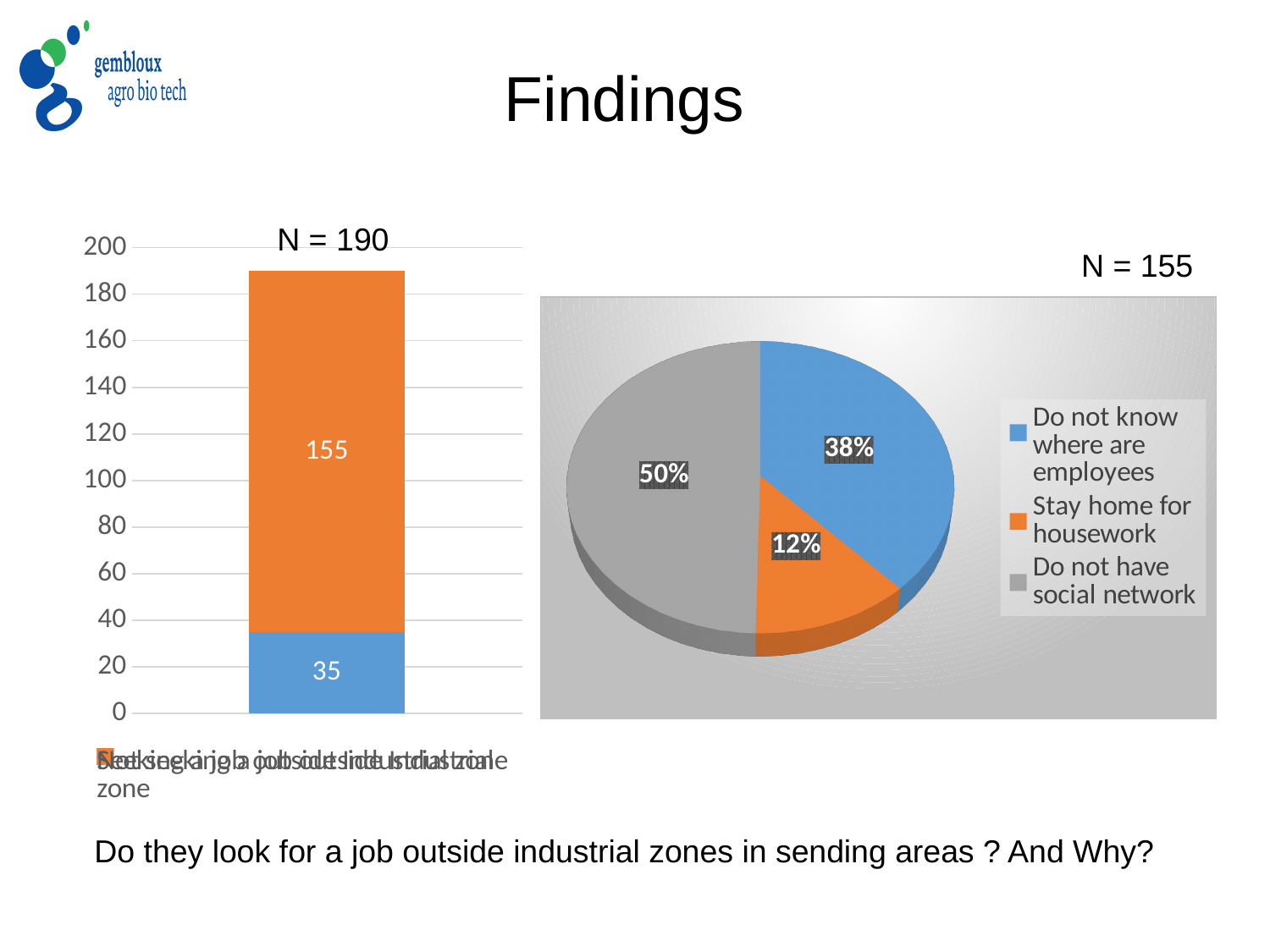
What type of chart is the chart on the left of the slide? bar chart In the pie chart on the right, what share is labelled for 'Do not know where are employees'? 38% In the pie chart on the right, what share is labelled for 'Stay home for housework'? 12% In the pie chart on the right, what share is labelled for 'Do not have social network'? 50% In the bar chart on the left, what is the difference between the orange segment value and the blue segment value? 120 In the bar chart on the left, what value is printed on the blue segment? 35 How many categories does the legend of the pie chart on the right list? 3 In the bar chart on the left, what is the total of the stacked bar? 190 In the bar chart on the left, what value is printed on the orange segment? 155 In the bar chart on the left, which segment is larger, the orange one or the blue one? orange In the pie chart on the right, which category has the smallest slice? Stay home for housework What type of chart is the chart on the right of the slide? pie chart